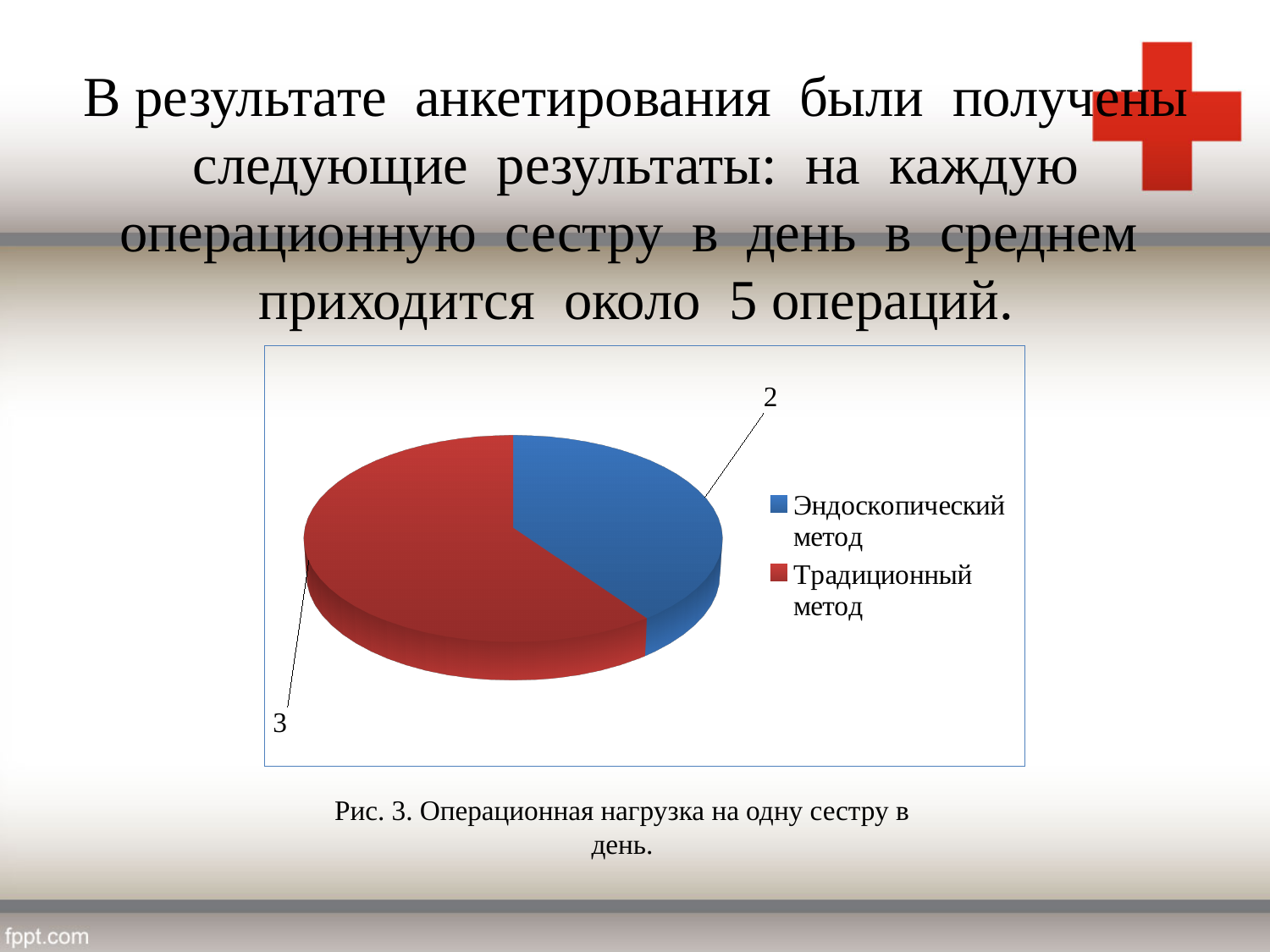
What share of the pie does Традиционный метод represent? 60% How many entries does the legend list? 2 Which category has the smallest slice? Эндоскопический метод What is the value for Традиционный метод? 3 How many slices does the pie chart have? 2 What colour is the slice for Эндоскопический метод? blue What is the total of the two values shown on the pie chart? 5 What is the difference between the values for Традиционный метод and Эндоскопический метод? 1 What is the value for Эндоскопический метод? 2 What kind of chart is shown on the slide? pie chart Which category has the largest slice? Традиционный метод Which is larger: the value for Эндоскопический метод or Традиционный метод? Традиционный метод